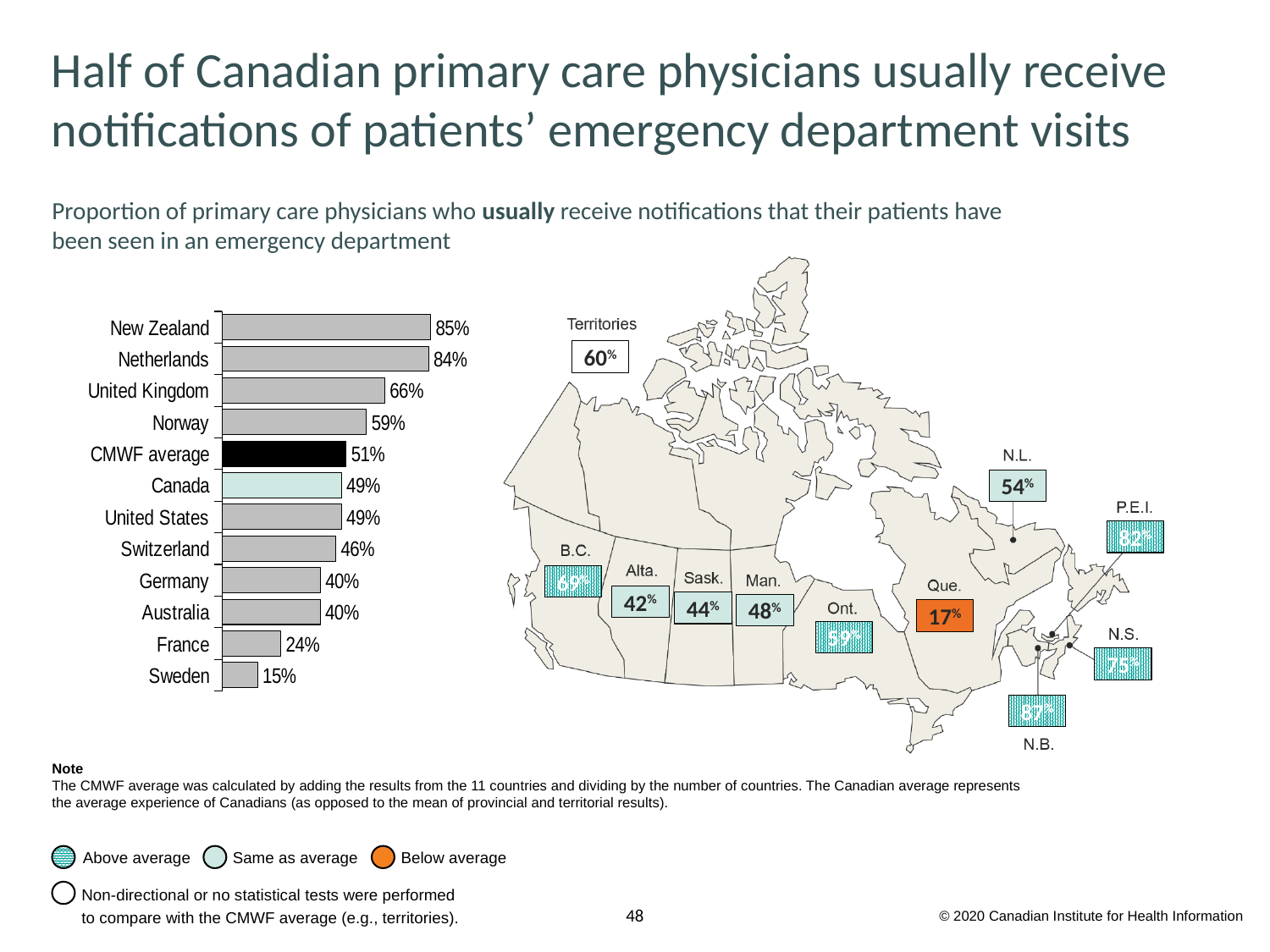
In the bar chart, what is the CMWF average? 51% In the bar chart, what is the difference between the values for the United Kingdom and France? 42% In the bar chart, what is the value for Canada? 49% In the bar chart, which is larger, the value for Norway or the value for Switzerland? Norway On the map, what is the value shown for New Brunswick (N.B.)? 87% What type of chart is shown on the left of the slide? Bar chart In the bar chart, which country has the lowest value? Sweden On the map, what is the value shown for Quebec (Que.)? 17% In the bar chart, what is the value for New Zealand? 85% How many bars are shown in the bar chart? 12 In the bar chart, which bar is coloured black? CMWF average In the bar chart, which country has the highest value? New Zealand